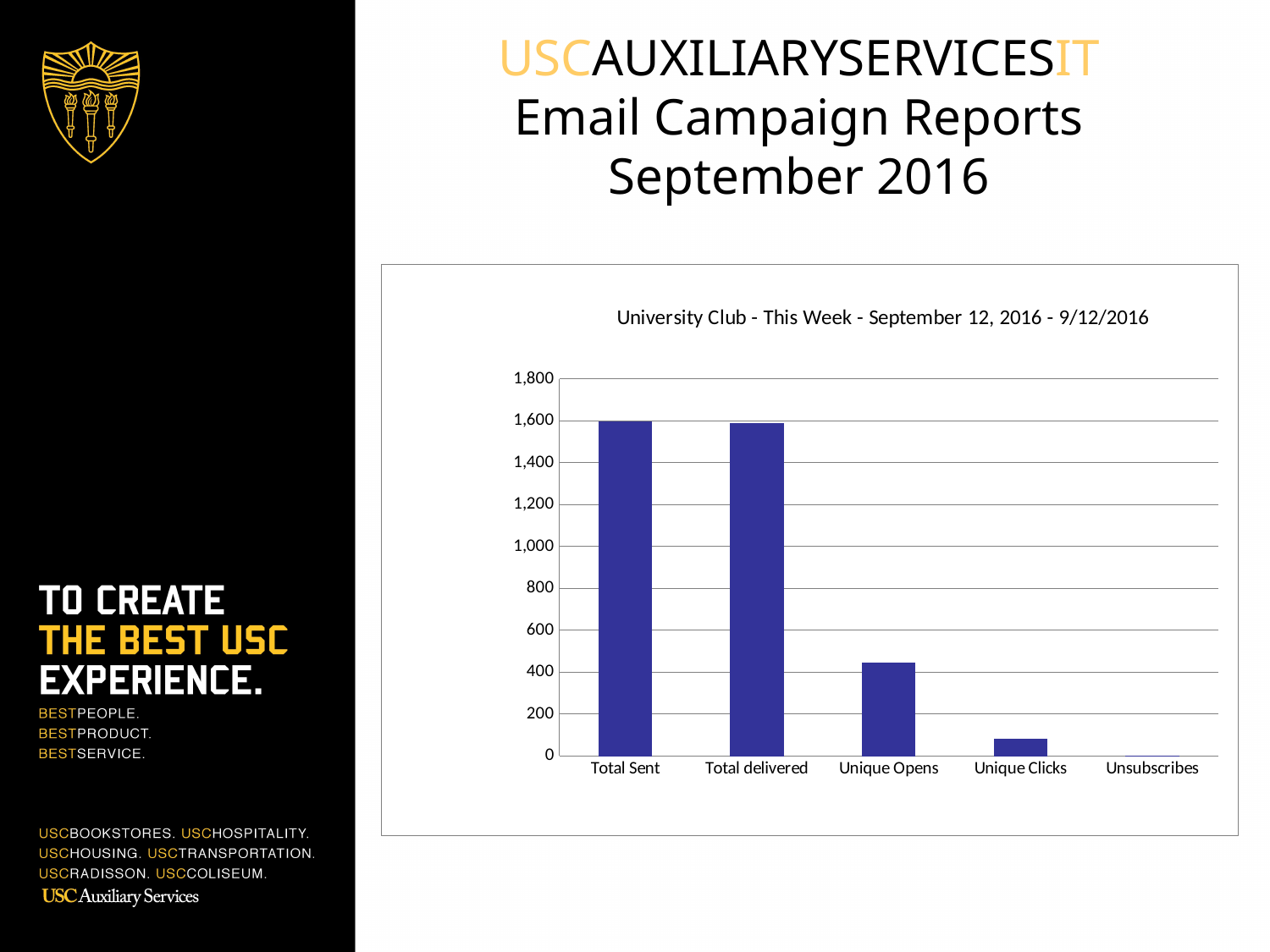
Which category has the lowest value in the chart? Unsubscribes How many categories are shown on the x axis of the chart? 5 Which is larger, the value for Unique Opens or the value for Unique Clicks? Unique Opens Do the values rise or fall moving from left to right along the x axis? fall Is the value for Total Sent greater or less than 1,400? greater What is the title of the chart? University Club - This Week - September 12, 2016 - 9/12/2016 What kind of chart is shown on the slide? bar chart Is the value for Unique Opens greater or less than 600? less Which is larger, the value for Total delivered or the value for Unique Opens? Total delivered Is the value for Unique Opens greater or less than 200? greater